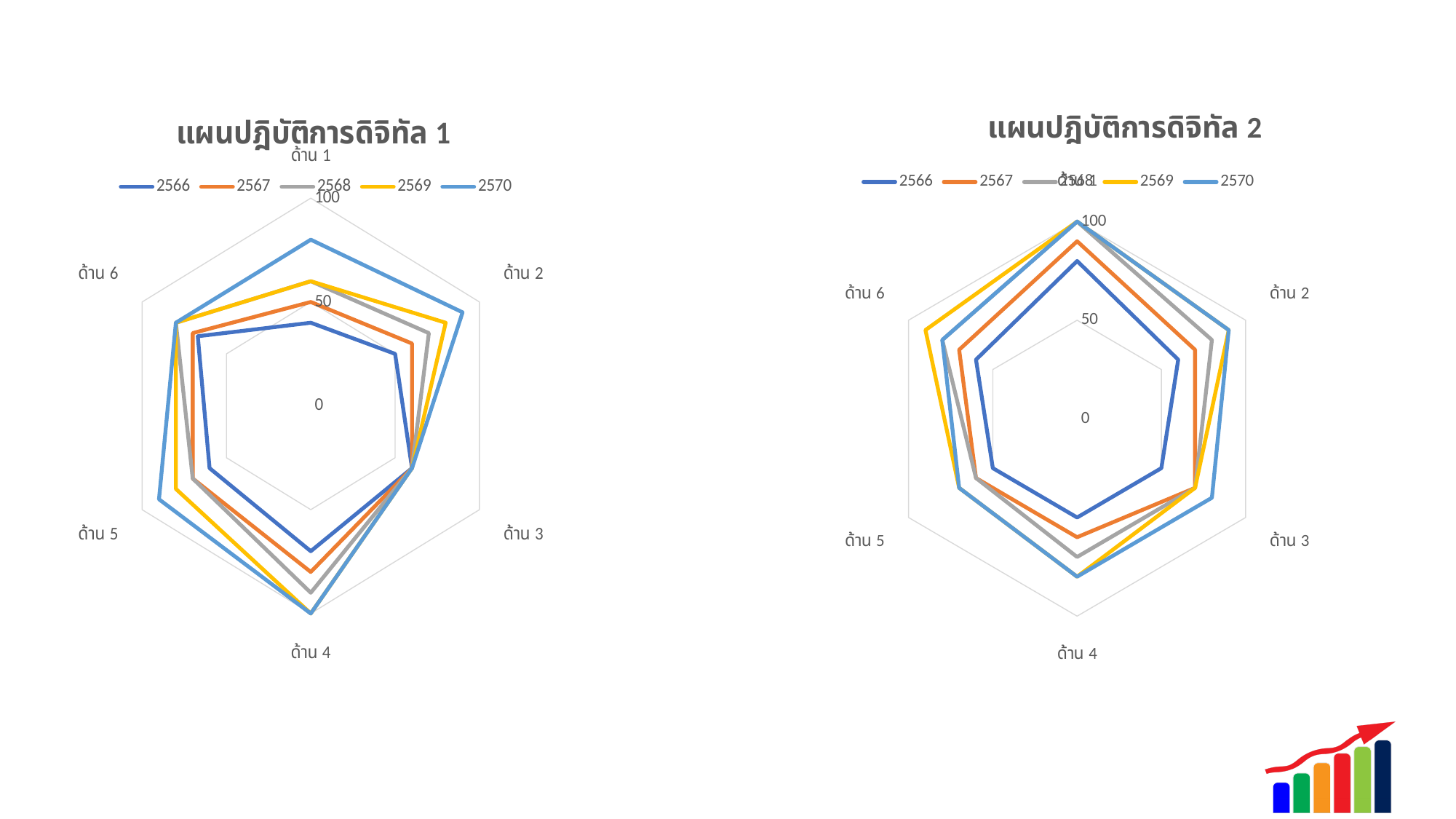
In the chart titled แผนปฏิบัติการดิจิทัล 2, which is larger at ด้าน 4: the value for 2570 or the value for 2566? 2570 In the chart titled แผนปฏิบัติการดิจิทัล 2, is the value for 2570 at ด้าน 4 greater or less than 50? greater In the chart titled แผนปฏิบัติการดิจิทัล 2, how many categories (axes) are plotted? 6 In the chart titled แผนปฏิบัติการดิจิทัล 2, what is the highest value shown on the axis scale? 100 In the chart titled แผนปฏิบัติการดิจิทัล 2, is the value for 2570 at ด้าน 1 greater or less than 50? greater In the chart titled แผนปฏิบัติการดิจิทัล 1, which is larger at ด้าน 1: the value for 2570 or the value for 2566? 2570 In the chart titled แผนปฏิบัติการดิจิทัล 1, is the value for 2570 at ด้าน 1 greater or less than 50? greater What kind of chart is the chart titled แผนปฏิบัติการดิจิทัล 1? radar chart What is the title of the chart on the right side of the slide? แผนปฎิบัติการดิจิทัล 2 In the chart titled แผนปฏิบัติการดิจิทัล 1, how many series does the legend list? 5